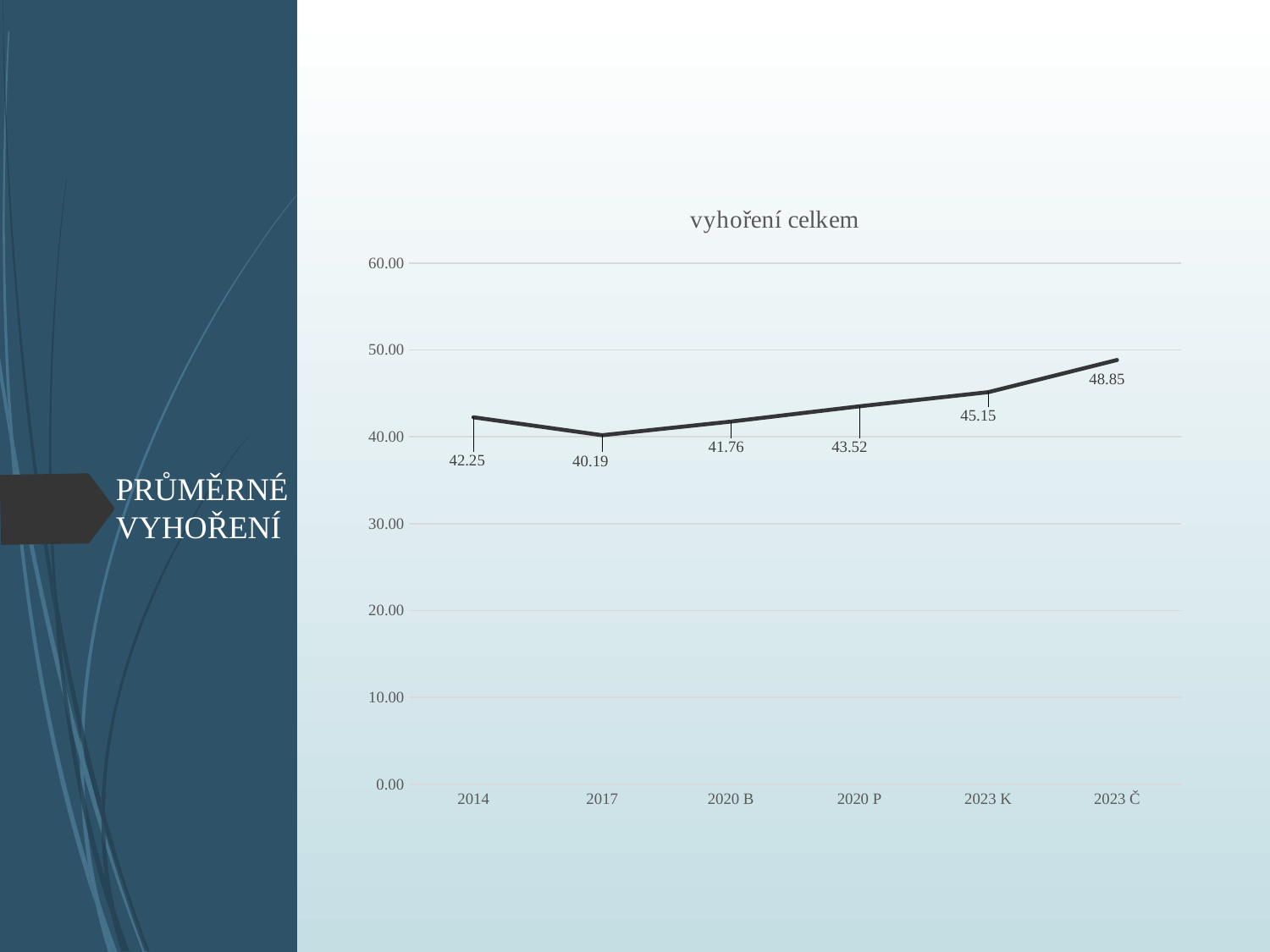
What is the value for 2020 P? 43.52 What is the difference between the values for 2023 Č and 2023 K? 3.70 What is the title of the chart? vyhoření celkem Is the value for 2023 K greater or less than 40.00? greater Which category has the lowest value? 2017 What is the value for 2014? 42.25 How many categories are shown on the x axis? 6 What is the value for 2023 Č? 48.85 Which is larger, the value for 2020 B or the value for 2020 P? 2020 P Which category has the highest value? 2023 Č What kind of chart is this? line chart What is the difference between the values for 2014 and 2017? 2.06